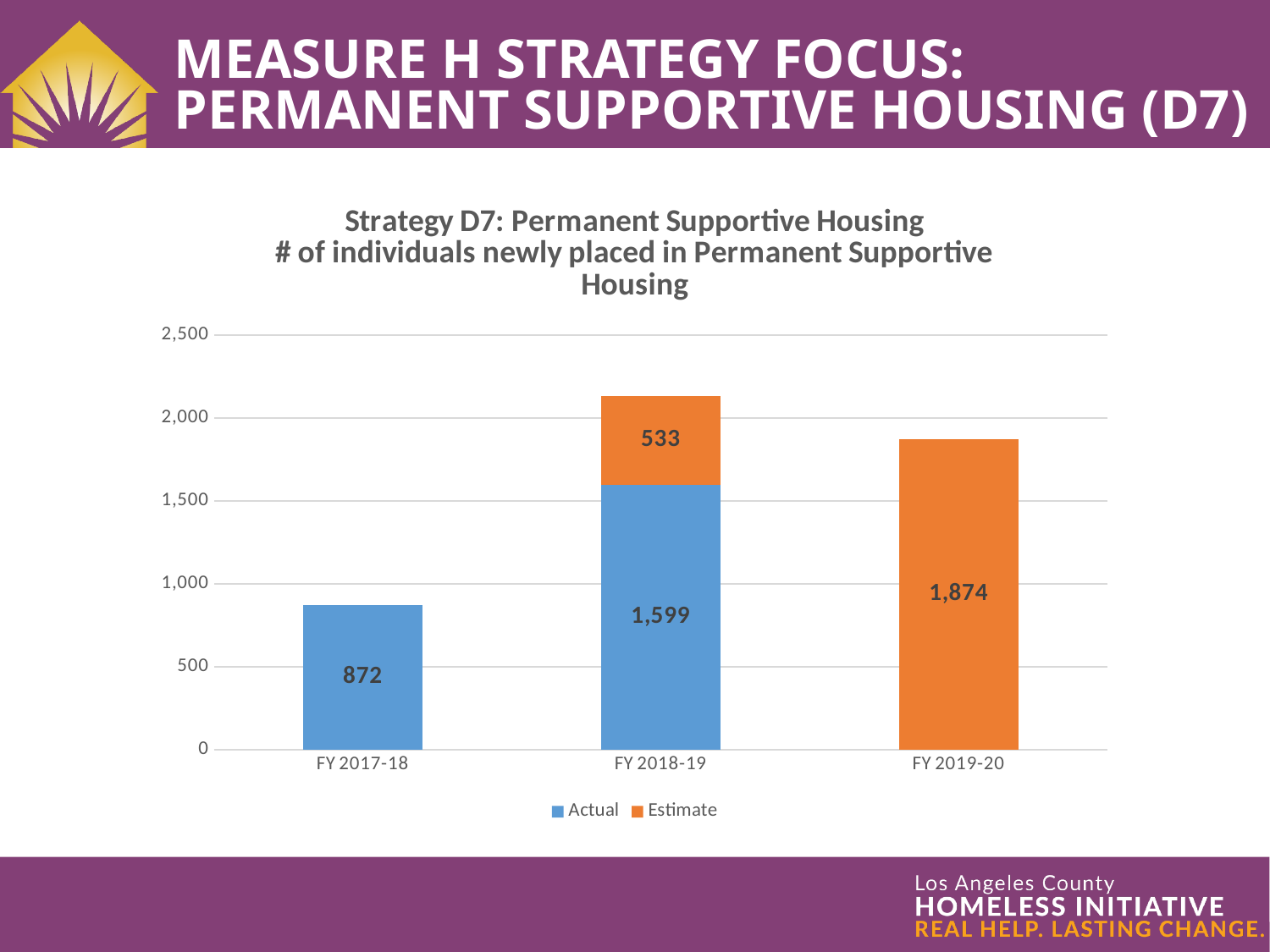
What is the Estimate value for FY 2018-19? 533 Which is larger, the Estimate for FY 2019-20 or the Actual for FY 2018-19? Estimate for FY 2019-20 What is the Actual value for FY 2018-19? 1,599 How many series does the legend list? 2 What is the total of the stacked bar for FY 2018-19? 2,132 How many fiscal years are shown on the x axis? 3 What is the Actual value for FY 2017-18? 872 What is the difference between the Actual values for FY 2018-19 and FY 2017-18? 727 What is the Estimate value for FY 2019-20? 1,874 What kind of chart is shown on the slide? Stacked bar chart Is the Actual value for FY 2017-18 greater or less than 1,000? less Which fiscal year has the lowest Actual value? FY 2017-18